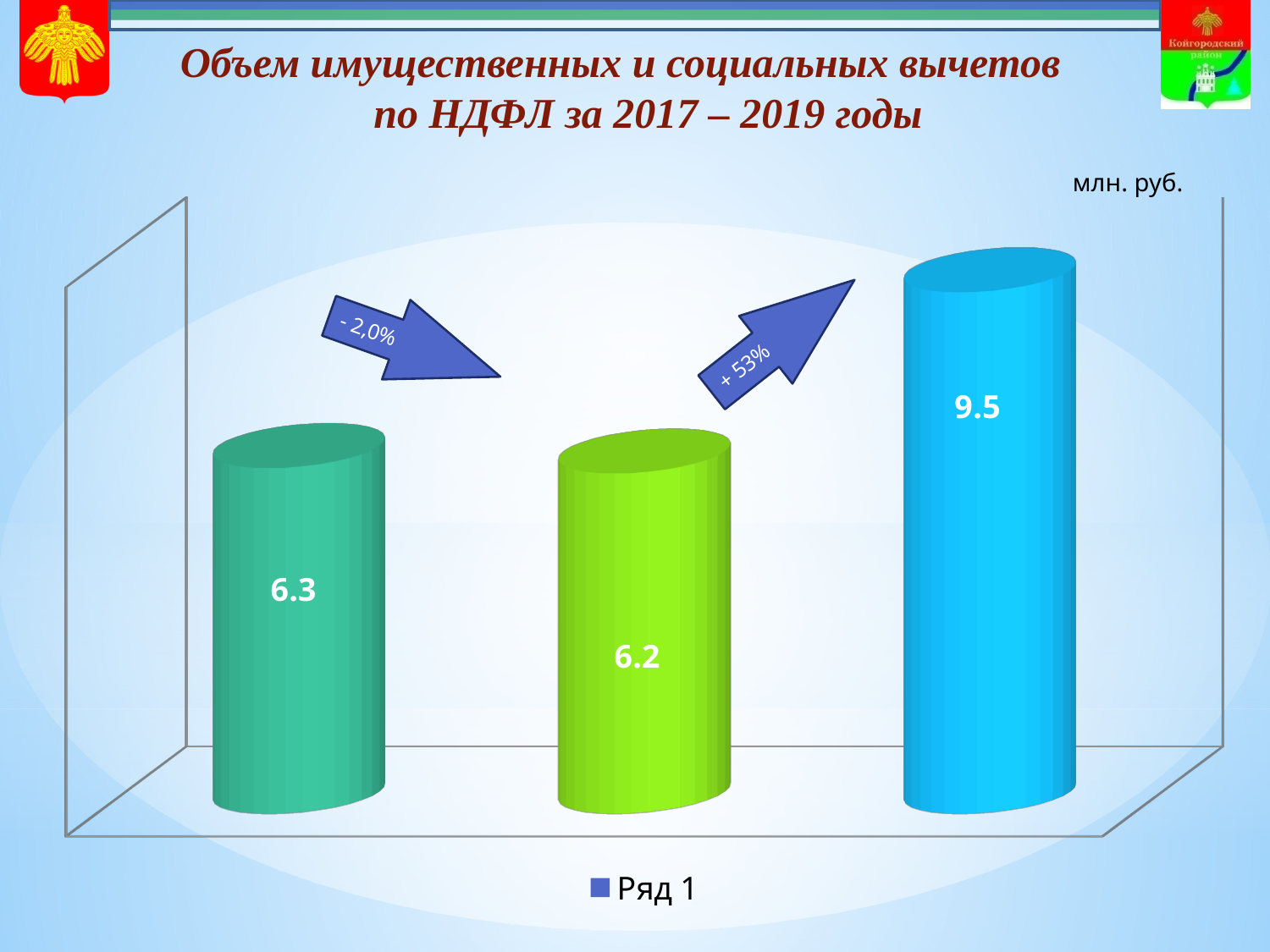
What value is shown on the right bar of the chart? 9.5 Which bar has the highest value? The right bar (9.5) Which is larger, the value of the left bar or the value of the middle bar? The left bar (6.3) What unit is indicated for the chart values? млн. руб. What value is shown on the left bar of the chart? 6.3 What value is shown on the middle bar of the chart? 6.2 What is the difference between the right bar's value and the left bar's value? 3.2 How many series does the legend list? 1 Which bar has the lowest value? The middle bar (6.2) What kind of chart is shown on the slide? Bar chart How many bars are plotted in the chart? 3 What is the difference between the right bar's value and the middle bar's value? 3.3